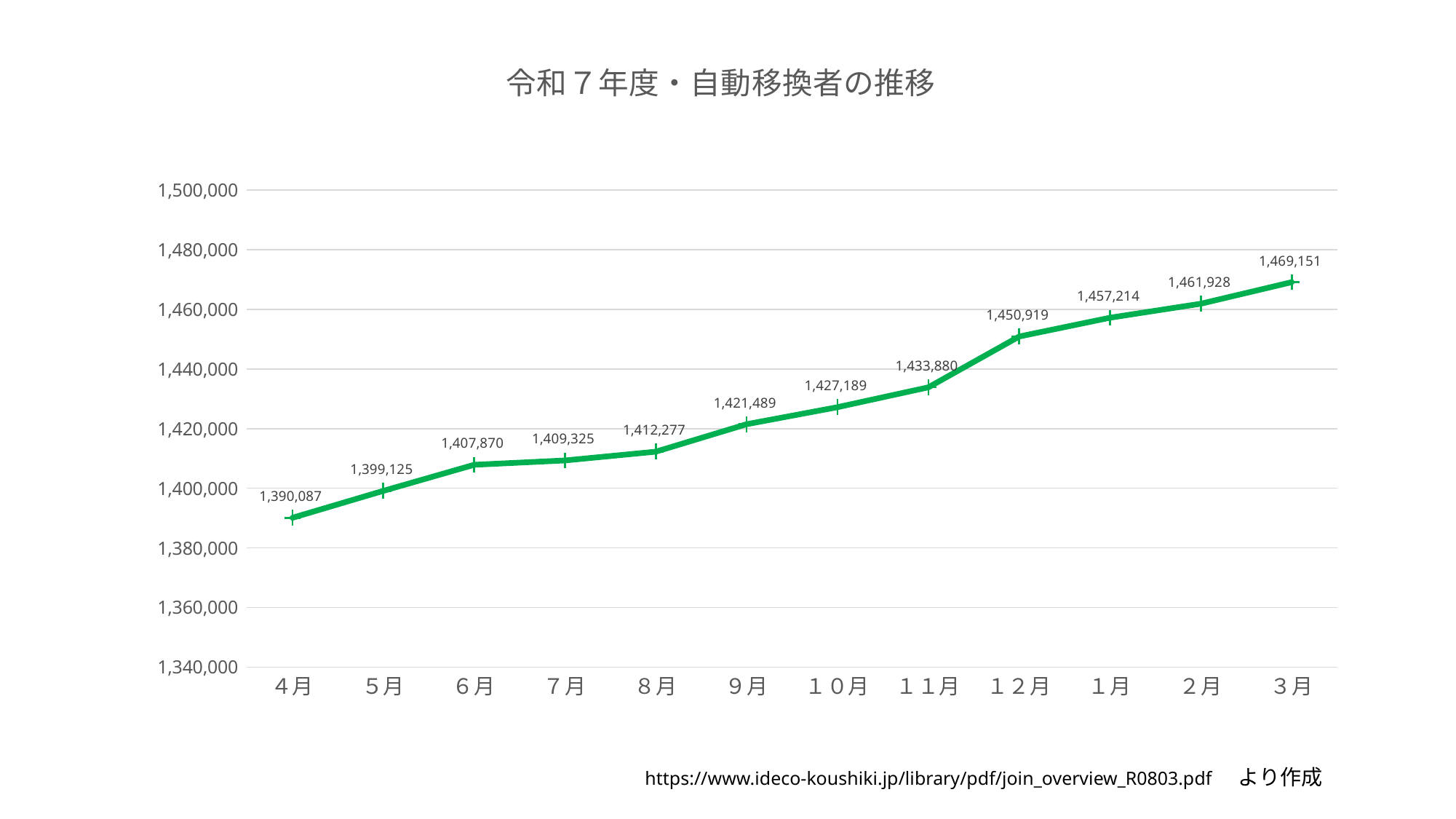
Which is larger, the value for 7月 or the value for 9月? 9月 What is the difference between the values for 12月 and 11月? 17,039 What type of chart is shown on the slide? line chart What is the value for 3月? 1,469,151 Which month has the highest value? 3月 What is the difference between the values for 3月 and 4月? 79,064 What is the value for 12月? 1,450,919 What is the value for 4月? 1,390,087 How many data points are plotted on the line? 12 Is the value for 8月 greater or less than 1,420,000? less Which month has the lowest value? 4月 What is the title of the chart? 令和７年度・自動移換者の推移